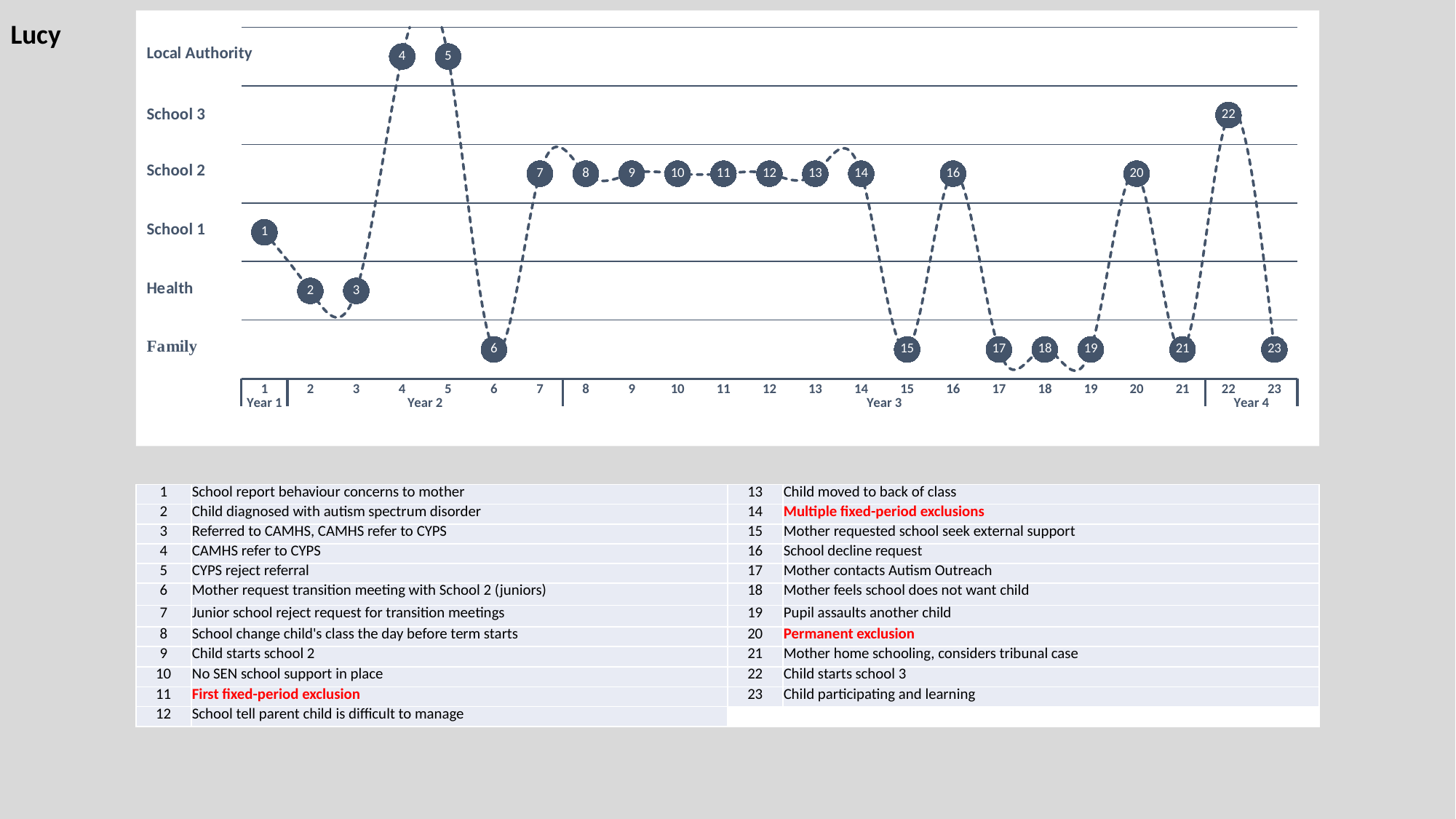
Which vertical-axis category does event 4 fall under? Local Authority How many category levels are labelled on the vertical axis of the chart? 6 Which vertical-axis category does event 6 fall under? Family Which year group contains events 8 through 21? Year 3 What is the name shown at the top left of the slide? Lucy Which events are plotted at the Local Authority level? 4 and 5 How many year groups are marked along the horizontal axis? 4 Which vertical-axis category does event 22 fall under? School 3 Which vertical-axis category does event 1 fall under? School 1 Which vertical-axis category do events 2 and 3 fall under? Health How many numbered event points are plotted on the chart? 23 What kind of chart is shown on the slide? Line chart